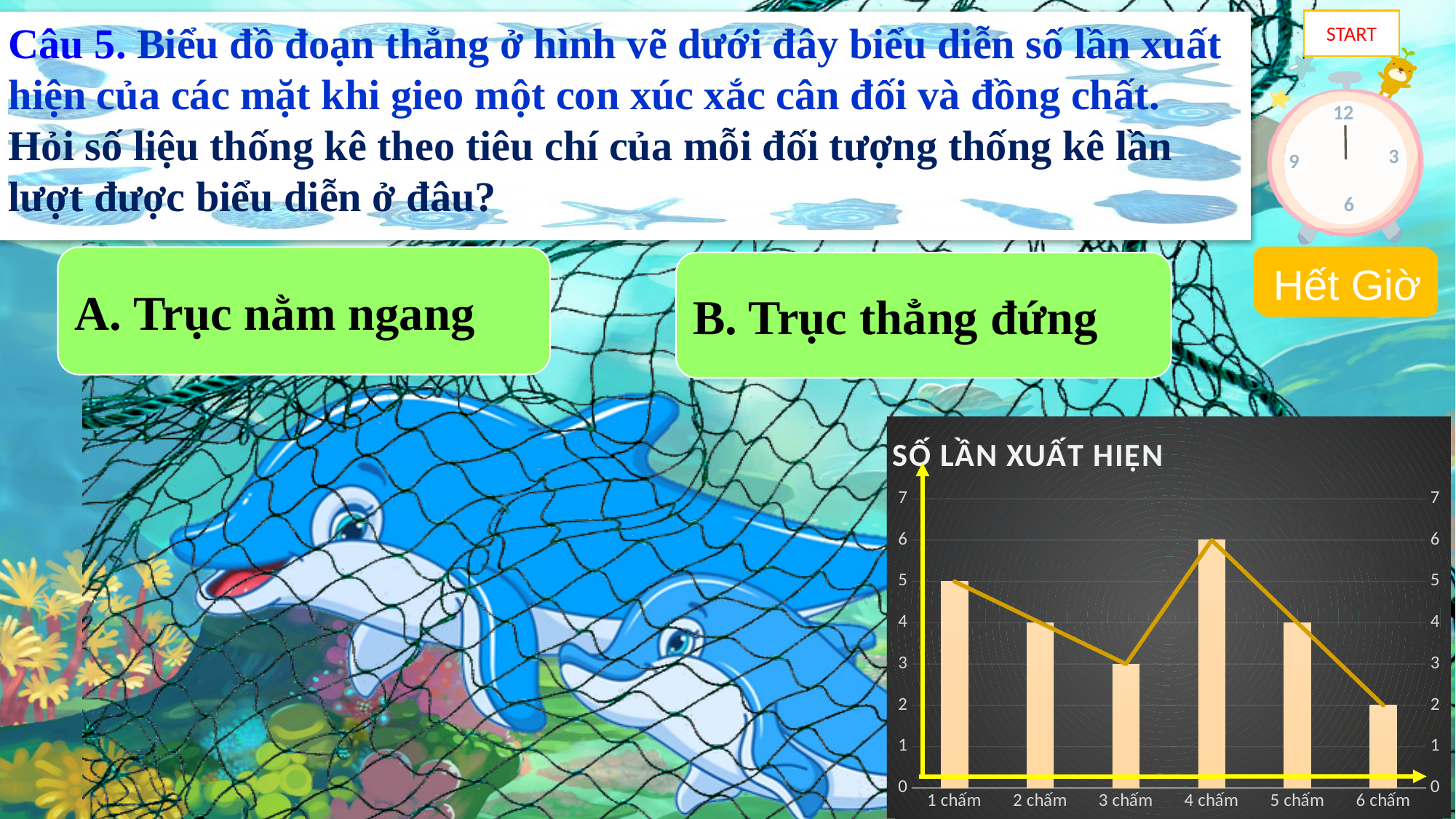
Which has a larger value, 1 chấm or 3 chấm? 1 chấm What is the title of the chart? SỐ LẦN XUẤT HIỆN How many categories are shown on the x axis of the chart? 6 What is the difference between the values for 1 chấm and 2 chấm? 1 What is the difference between the values for 4 chấm and 6 chấm? 4 Is the value for 1 chấm greater or less than 4? greater What is the value for 4 chấm in the chart? 6 Do the values rise or fall from 4 chấm to 6 chấm? fall Which category has the lowest value in the chart? 6 chấm Which category has the highest value in the chart? 4 chấm What is the value for 6 chấm in the chart? 2 What is the value for 3 chấm in the chart? 3